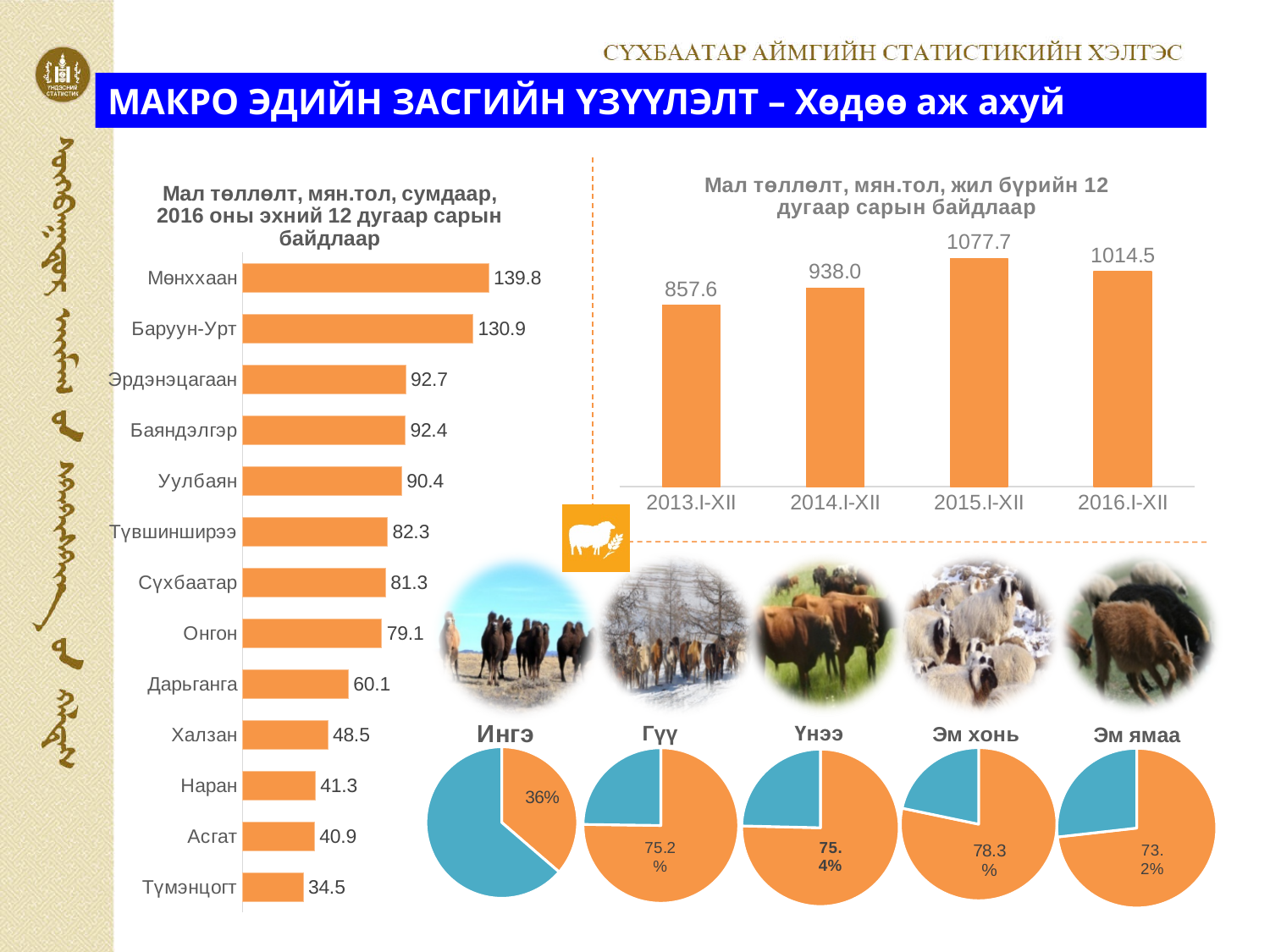
In the top-right chart 'Мал төллөлт, мян.тол, жил бүрийн 12 дугаар сарын байдлаар', what is the value for 2015.I-XII? 1077.7 In the left chart by soum, what is the difference between Мөнххаан and Баруун-Урт? 8.9 In the top-right chart by year, which year has the lowest value? 2013.I-XII In the left chart by soum, which soum has the lowest value? Түмэнцогт In the top-right chart by year, what is the difference between 2014.I-XII and 2013.I-XII? 80.4 In the top-right chart by year, is the value for 2016.I-XII larger or smaller than the value for 2015.I-XII? smaller In the pie chart labelled 'Эм хонь', what share is shown by the data label? 78.3% What type of chart is the top-right chart 'Мал төллөлт, мян.тол, жил бүрийн 12 дугаар сарын байдлаар'? bar chart In the left chart by soum, what is the value for Дарьганга? 60.1 In the left chart by soum, how many soums are shown? 13 In the left chart 'Мал төллөлт, мян.тол, сумдаар, 2016 оны эхний 12 дугаар сарын байдлаар', what is the value for Мөнххаан? 139.8 In the left chart by soum, which soum has the highest value? Мөнххаан